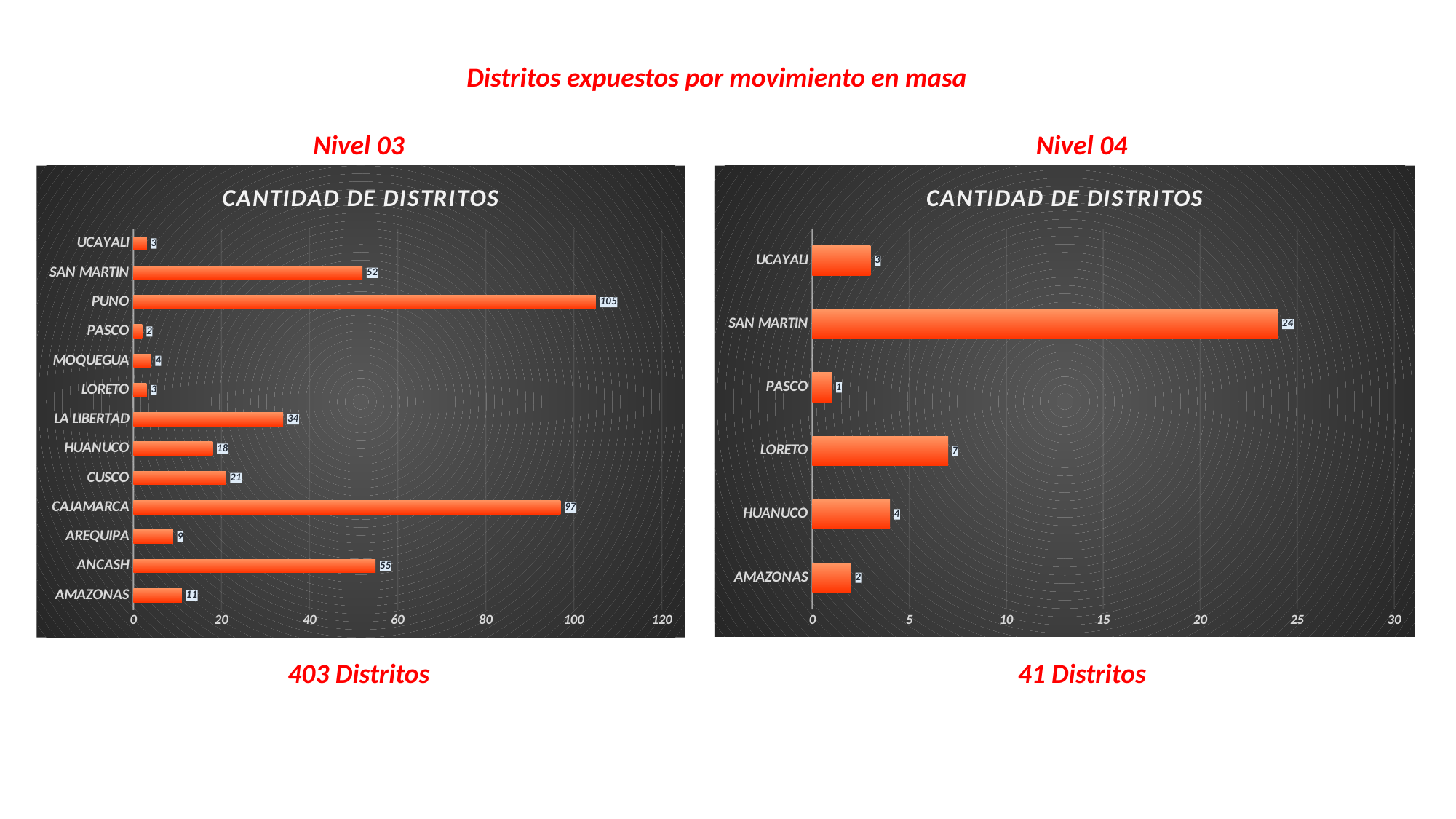
What type of chart is the Nivel 03 chart? Bar chart In the Nivel 04 chart, what is the difference between the values for SAN MARTIN and LORETO? 17 How many categories are shown in the Nivel 03 chart? 13 In the Nivel 03 chart, what is the value for CAJAMARCA? 97 In the Nivel 03 chart, what is the difference between the values for ANCASH and SAN MARTIN? 3 In the Nivel 03 chart, what is the value for PUNO? 105 In the Nivel 04 chart, which category has the lowest value? PASCO In the Nivel 03 chart, which category has the highest value? PUNO How many categories are shown in the Nivel 04 chart? 6 In the Nivel 03 chart, which is larger, the value for LA LIBERTAD or the value for CUSCO? LA LIBERTAD In the Nivel 04 chart, what is the value for LORETO? 7 In the Nivel 04 chart, what is the value for SAN MARTIN? 24